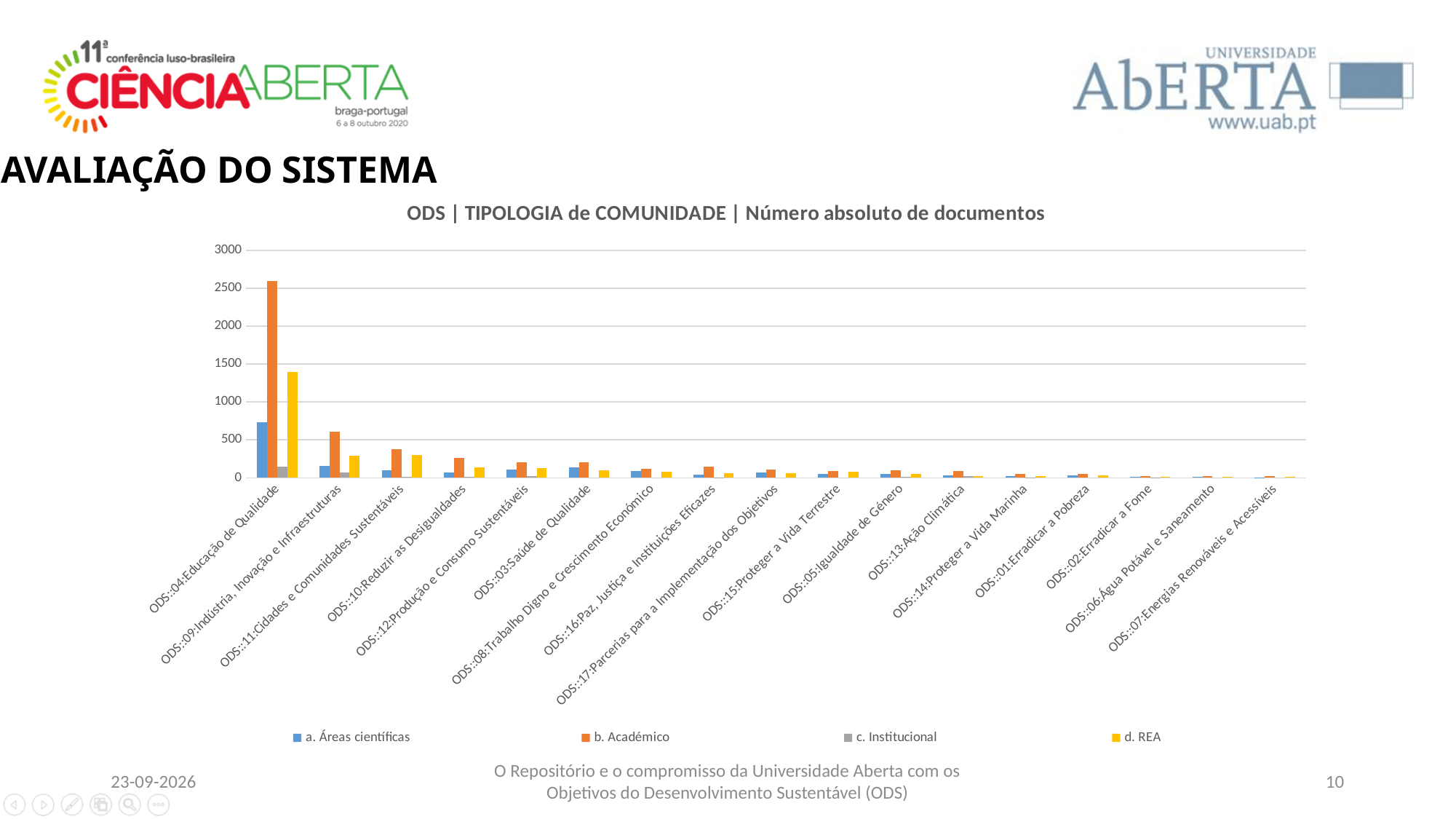
Is the a. Áreas científicas value for ODS::04:Educação de Qualidade greater or less than 1000? less Is the d. REA value for ODS::09:Indústria, Inovação e Infraestruturas greater or less than 500? less How many series does the legend list? 4 What is the title of the chart? ODS | TIPOLOGIA de COMUNIDADE | Número absoluto de documentos What kind of chart is shown on the slide? Bar chart Is the b. Académico value for ODS::04:Educação de Qualidade greater or less than 2000? greater For ODS::04:Educação de Qualidade, which is larger: the d. REA value or the a. Áreas científicas value? d. REA Do the b. Académico values generally rise or fall moving from left to right along the x axis? fall Which category has the highest value for the b. Académico series? ODS::04:Educação de Qualidade How many ODS categories are shown on the x axis? 17 Which series has the highest value for ODS::04:Educação de Qualidade? b. Académico